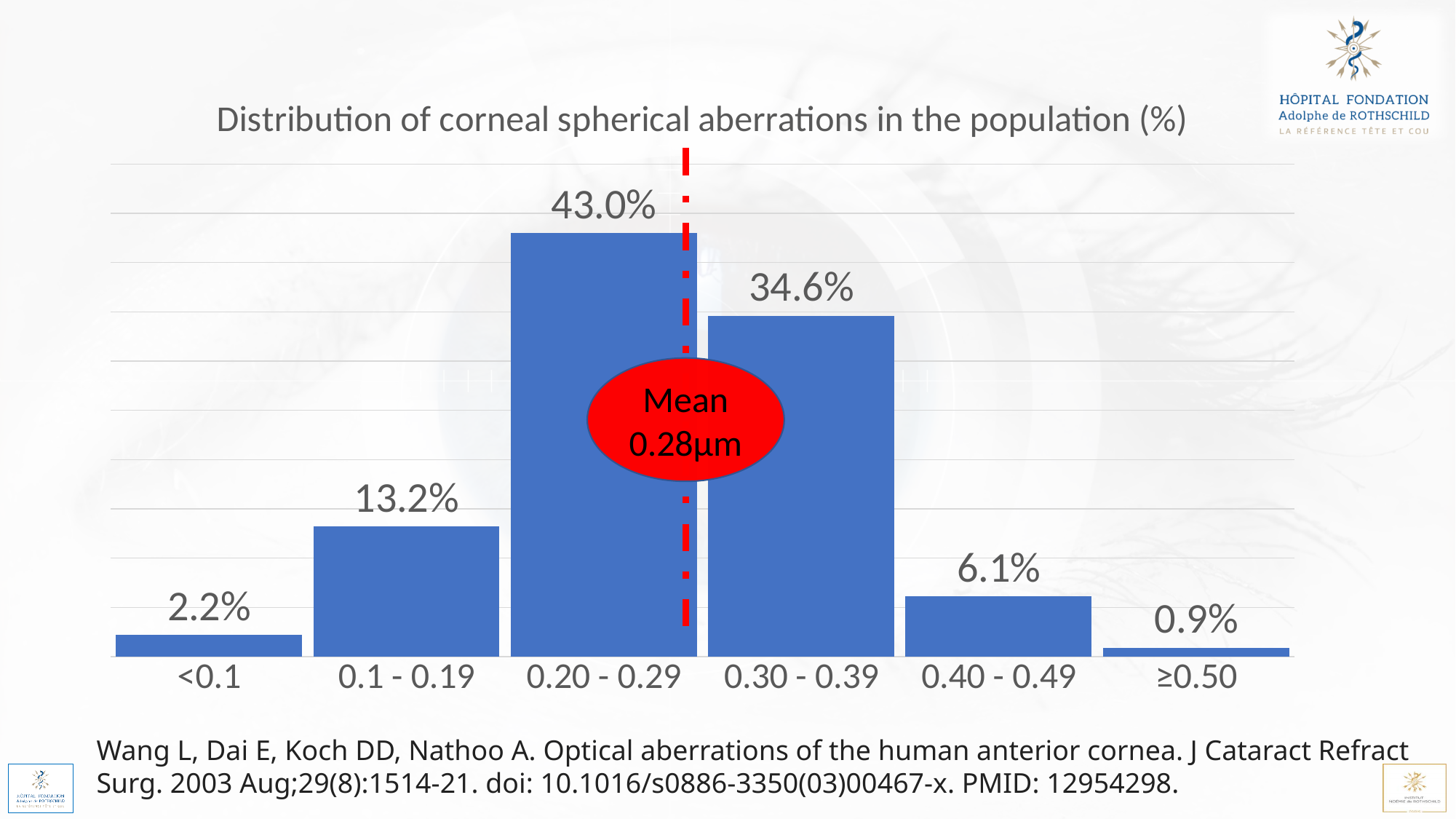
What is the difference between the values for 0.1 - 0.19 and 0.40 - 0.49? 7.1% What is the value for the 0.40 - 0.49 category? 6.1% Which category has the highest value? 0.20 - 0.29 What mean value is indicated by the red label on the chart? 0.28µm What is the difference between the values for 0.20 - 0.29 and 0.30 - 0.39? 8.4% What is the title of the chart? Distribution of corneal spherical aberrations in the population (%) What is the value for the 0.20 - 0.29 category? 43.0% What is the value for the <0.1 category? 2.2% Which category has the lowest value? ≥0.50 How many categories are shown on the x axis? 6 What kind of chart is shown on the slide? bar chart Which is larger, the value for 0.1 - 0.19 or the value for 0.40 - 0.49? 0.1 - 0.19